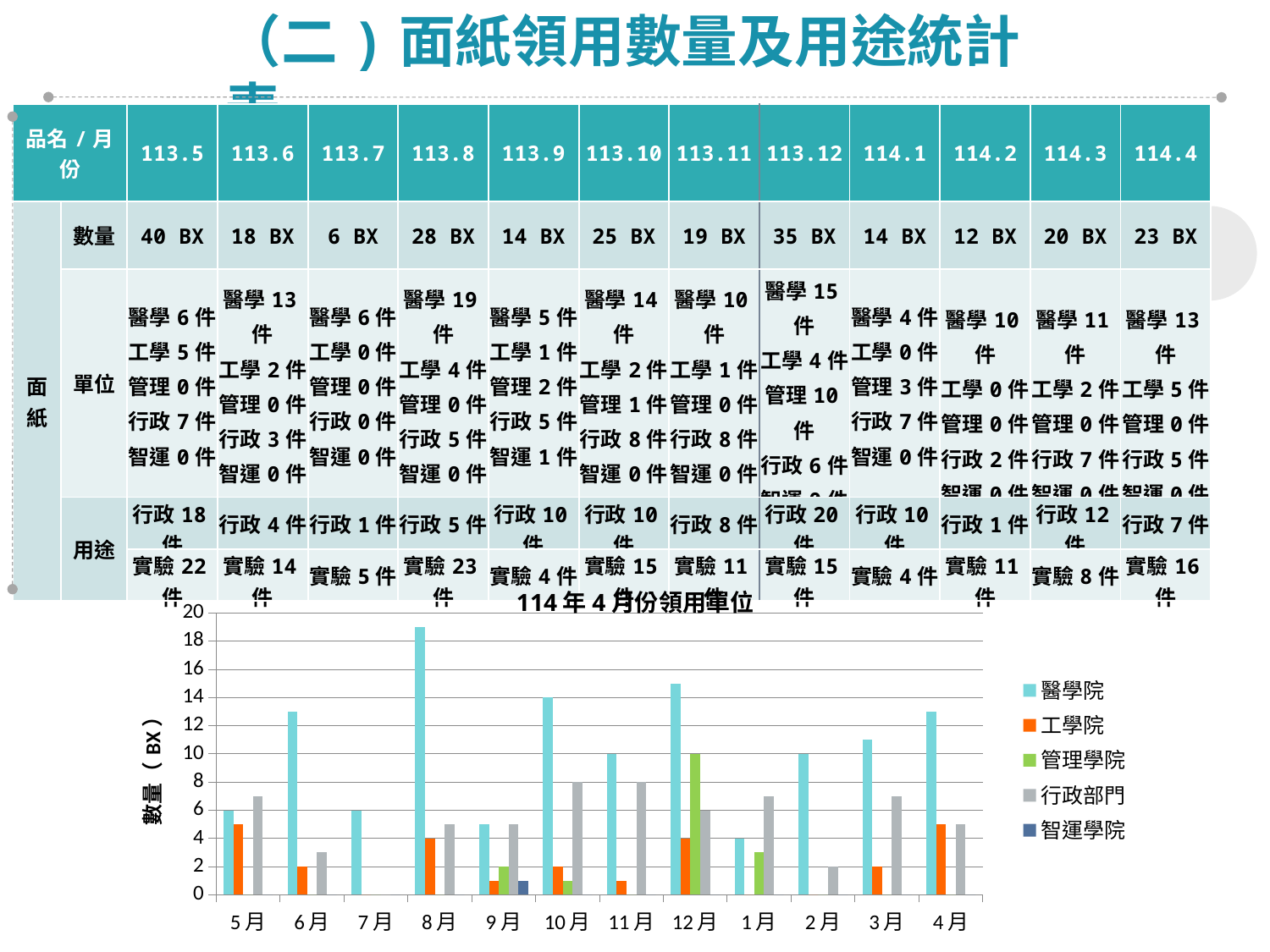
What is the value of the 醫學院 bar for 10月? 14 What is the value of the 管理學院 bar for 12月? 10 How many months are shown along the x axis of the chart? 12 What is the label on the vertical axis of the chart? 數量（BX） Is the value of the 智運學院 bar for 9月 greater or less than 2? less Is the value of the 醫學院 bar for 8月 greater or less than 16? greater For 12月, which is larger: the 醫學院 bar or the 行政部門 bar? 醫學院 What is the value of the 行政部門 bar for 11月? 8 In which month is the 醫學院 bar the highest? 8月 What kind of chart is shown on the slide? bar chart What is the difference between the 醫學院 bar and the 行政部門 bar for 10月? 6 How many series does the chart legend list? 5